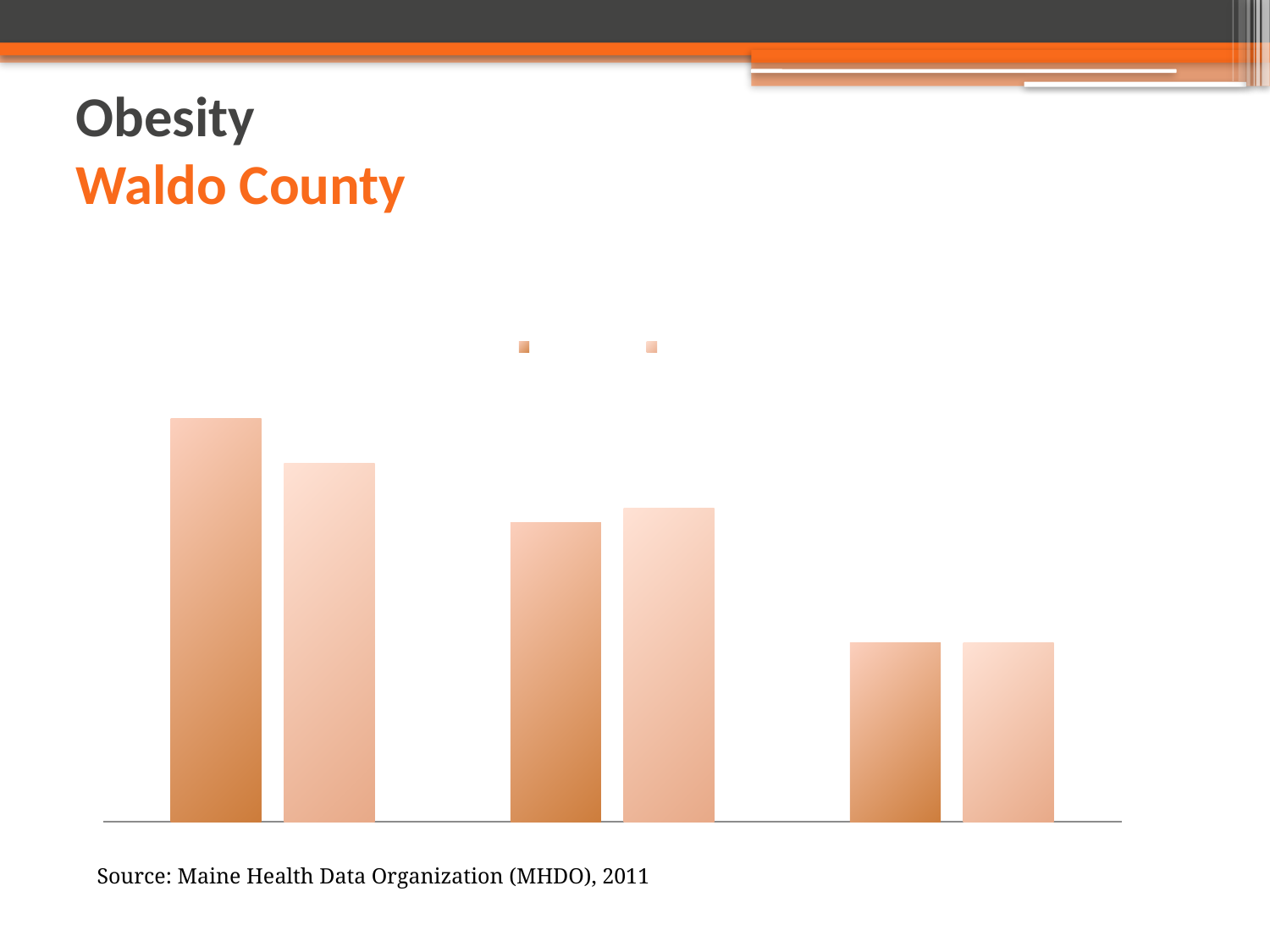
How many series does the chart's legend list? 2 Which group of bars is the shortest: the leftmost, middle, or rightmost? rightmost In the middle group, which bar is taller: the darker orange bar or the lighter orange bar? the lighter orange bar Do the bar heights generally rise or fall from left to right across the chart? fall How many groups of bars does the chart show? 3 What source is cited below the chart? Maine Health Data Organization (MHDO), 2011 What kind of chart is shown on the slide? bar chart How many bars are plotted in total on the chart? 6 In the leftmost group, which bar is taller: the darker orange bar or the lighter orange bar? the darker orange bar What is the title of the slide containing the chart? Obesity Waldo County Which group of bars is the tallest: the leftmost, middle, or rightmost? leftmost